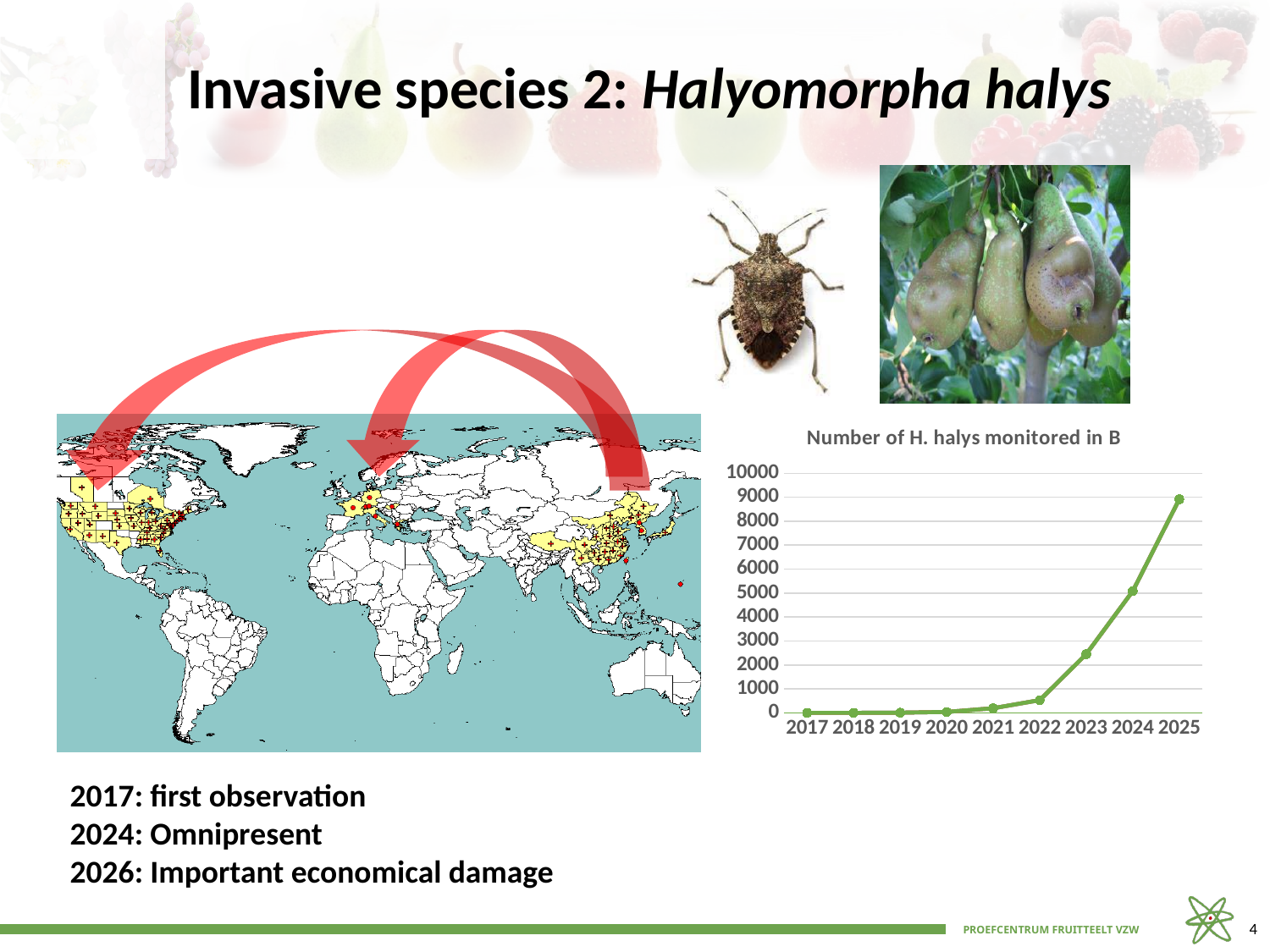
Is the value for 2023 greater or less than 3000? less How many years are plotted on the x axis of the chart? 9 Which year has the highest number of H. halys monitored? 2025 Do the values rise or fall from 2017 to 2025? rise What is the title of the chart? Number of H. halys monitored in B Which year has the larger value, 2023 or 2024? 2024 What kind of chart is shown on the slide? line chart What is the highest tick value shown on the y axis? 10000 Is the value for 2024 greater or less than 4000? greater Is the value for 2022 greater or less than 1000? less Which year is the first on the x axis of the chart? 2017